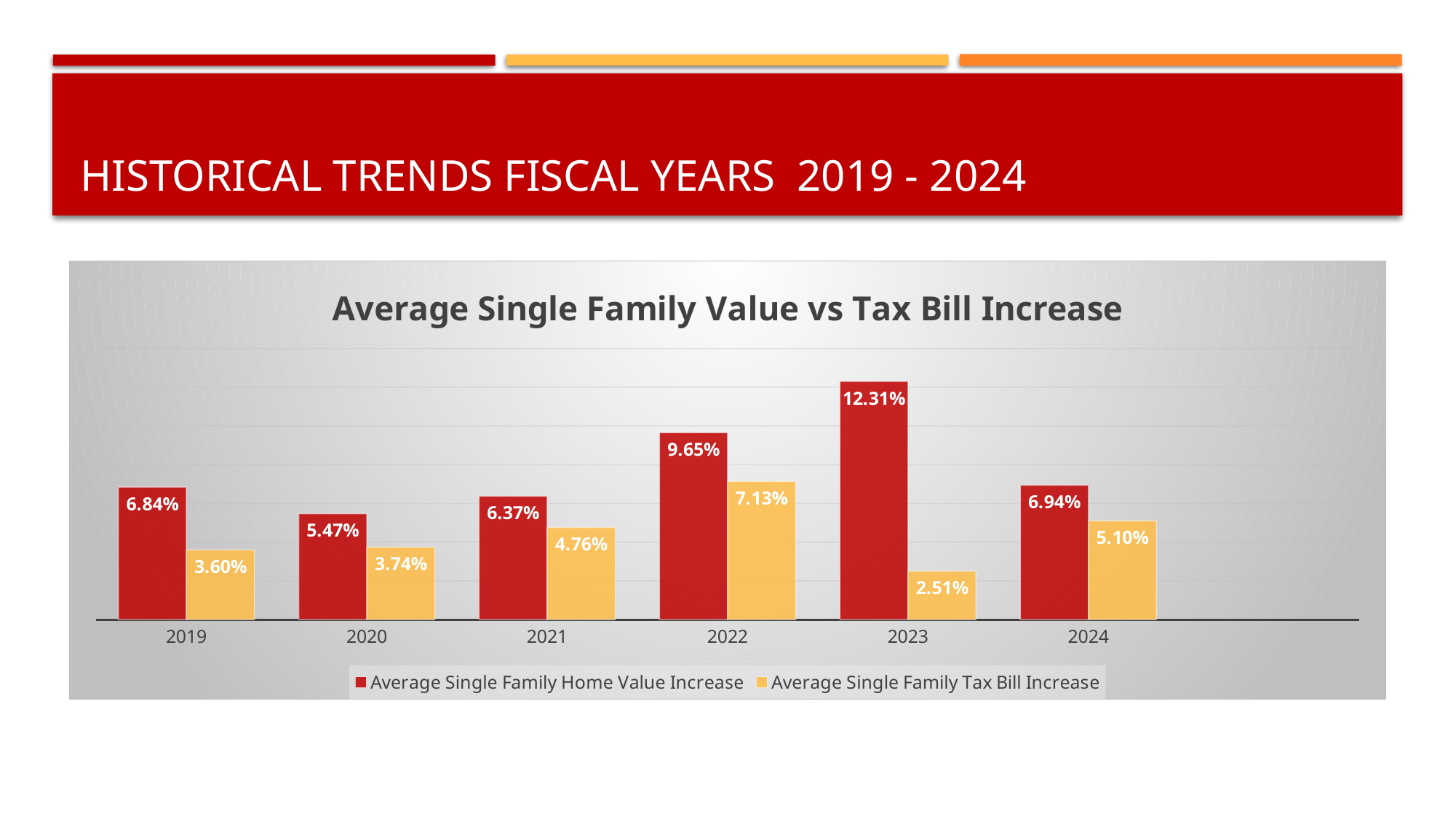
What kind of chart is shown on the slide? Bar chart How many series does the chart's legend list? 2 Which year has the highest Average Single Family Home Value Increase? 2023 What is the Average Single Family Tax Bill Increase for 2024? 5.10% Which year has the lowest Average Single Family Tax Bill Increase? 2023 How many years are shown on the x axis of the chart? 6 What is the title of the chart? Average Single Family Value vs Tax Bill Increase What is the Average Single Family Home Value Increase for 2023? 12.31% What is the difference between the Average Single Family Home Value Increase and the Average Single Family Tax Bill Increase in 2023? 9.80% Which is larger in 2020: the Average Single Family Home Value Increase or the Average Single Family Tax Bill Increase? Average Single Family Home Value Increase What is the Average Single Family Tax Bill Increase for 2021? 4.76% Which year has the highest Average Single Family Tax Bill Increase? 2022